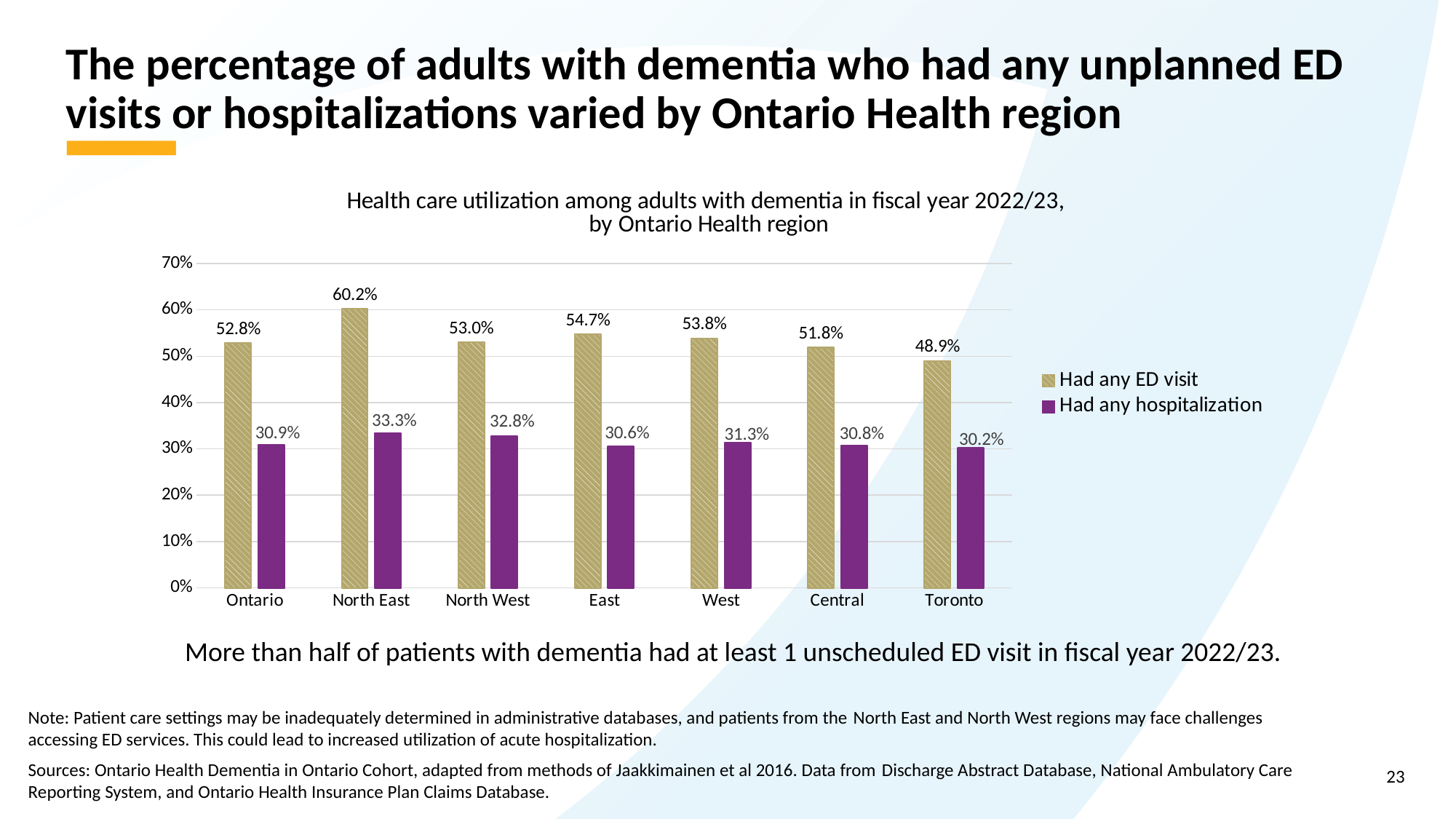
What percentage of adults with dementia in the North East region had any ED visit? 60.2% Which region has the highest percentage of adults with dementia who had any hospitalization? North East Which region has the highest percentage of adults with dementia who had any ED visit? North East How many regions (categories) are shown on the x axis of the chart? 7 What is the difference between the 'Had any ED visit' and 'Had any hospitalization' values for Ontario? 21.9 percentage points What is the value for 'Had any ED visit' in the West region? 53.8% Which is larger: the 'Had any ED visit' value for East or for Central? East How many series does the chart legend list? 2 What are the two series listed in the chart legend? Had any ED visit; Had any hospitalization What kind of chart is shown on the slide? Bar chart What percentage of adults with dementia in Toronto had any hospitalization? 30.2% Which region has the lowest percentage of adults with dementia who had any ED visit? Toronto